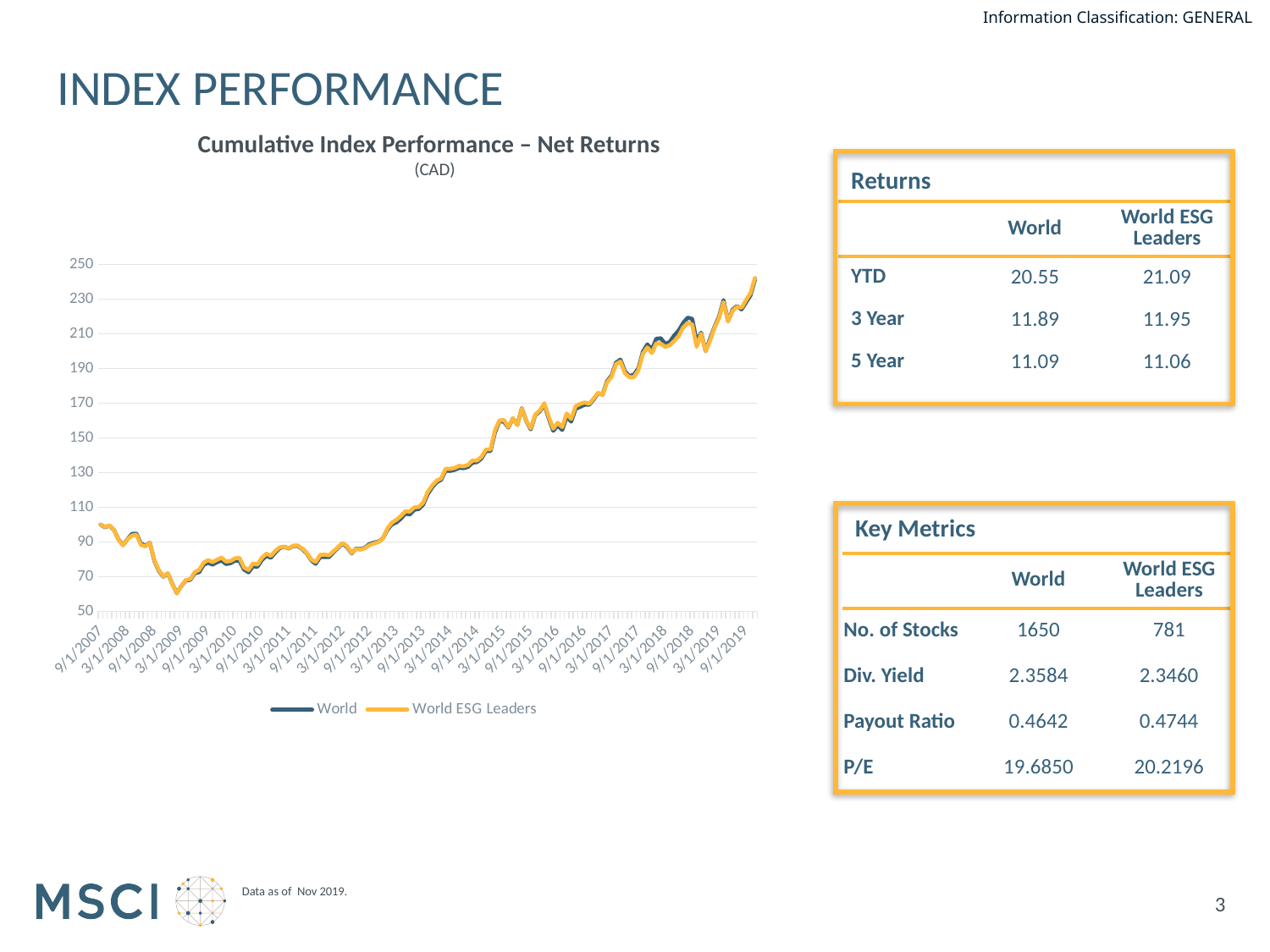
How many series does the chart's legend list? 2 Which series is drawn in yellow in the chart? World ESG Leaders What kind of chart is shown on the slide? line chart Is the value for World ESG Leaders at 3/1/2012 greater or less than 110? less Overall, do the index values rise or fall from 9/1/2007 to 9/1/2019? rise Is the value for World at 9/1/2016 greater or less than 150? greater Is the value for World at 3/1/2009 greater or less than 70? less What is the highest value shown on the chart's y axis? 250 What is the title of the chart? Cumulative Index Performance – Net Returns Do the index values rise or fall between 9/1/2007 and 3/1/2009? fall How many date labels are shown on the chart's x axis? 25